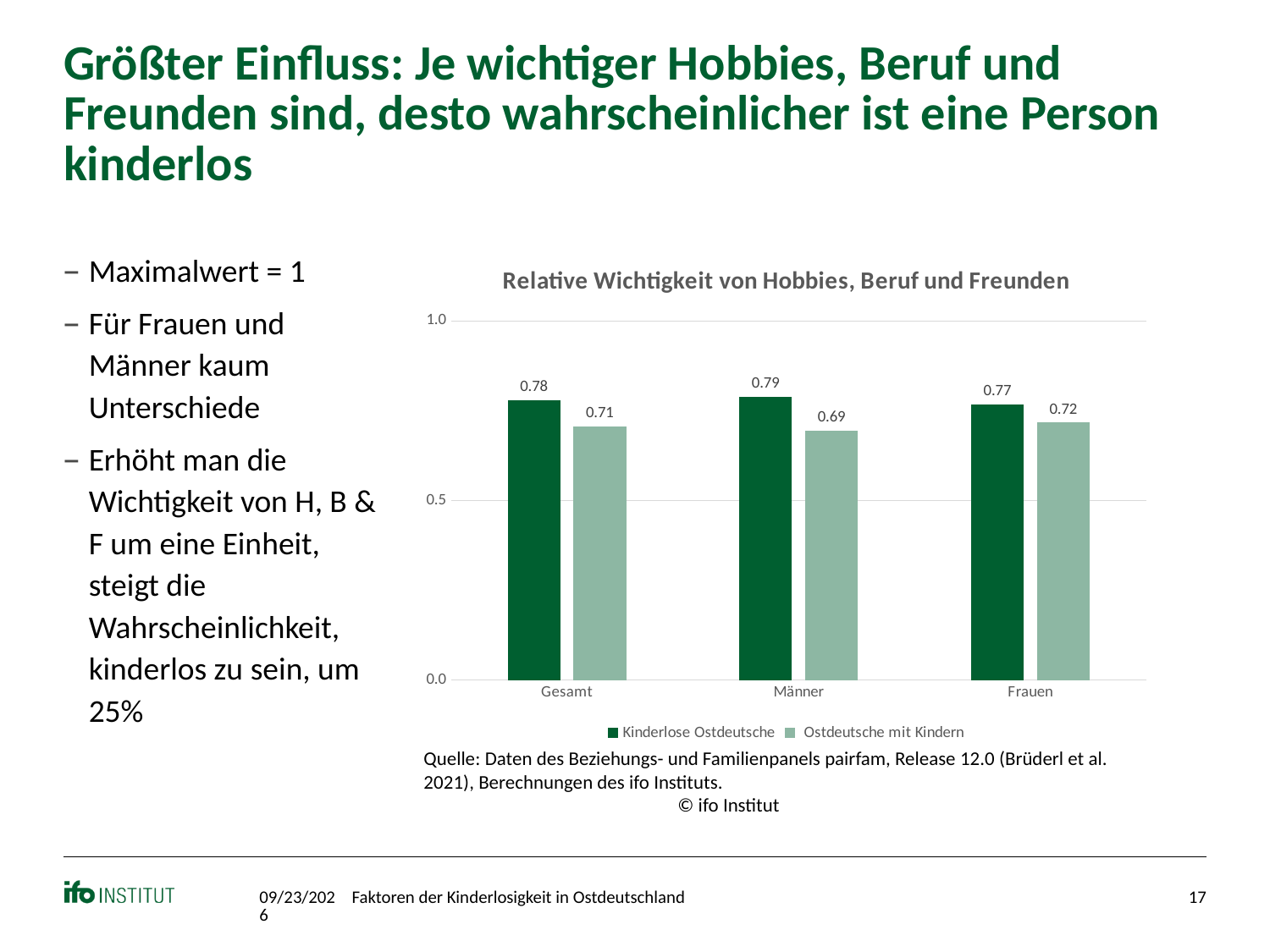
What is the value for Kinderlose Ostdeutsche in the Gesamt category? 0.78 What is the title of the chart? Relative Wichtigkeit von Hobbies, Beruf und Freunden What is the difference between Kinderlose Ostdeutsche and Ostdeutsche mit Kindern in the Männer category? 0.10 What is the value for Ostdeutsche mit Kindern in the Männer category? 0.69 What kind of chart is shown on the slide? bar chart How many categories are shown on the x axis? 3 Which category has the lowest value for Ostdeutsche mit Kindern? Männer In the Frauen category, which series has the larger value, Kinderlose Ostdeutsche or Ostdeutsche mit Kindern? Kinderlose Ostdeutsche Which category has the highest value for Kinderlose Ostdeutsche? Männer Is the value for Ostdeutsche mit Kindern in the Gesamt category greater or less than 0.5? greater How many series does the legend list? 2 What is the value for Ostdeutsche mit Kindern in the Frauen category? 0.72